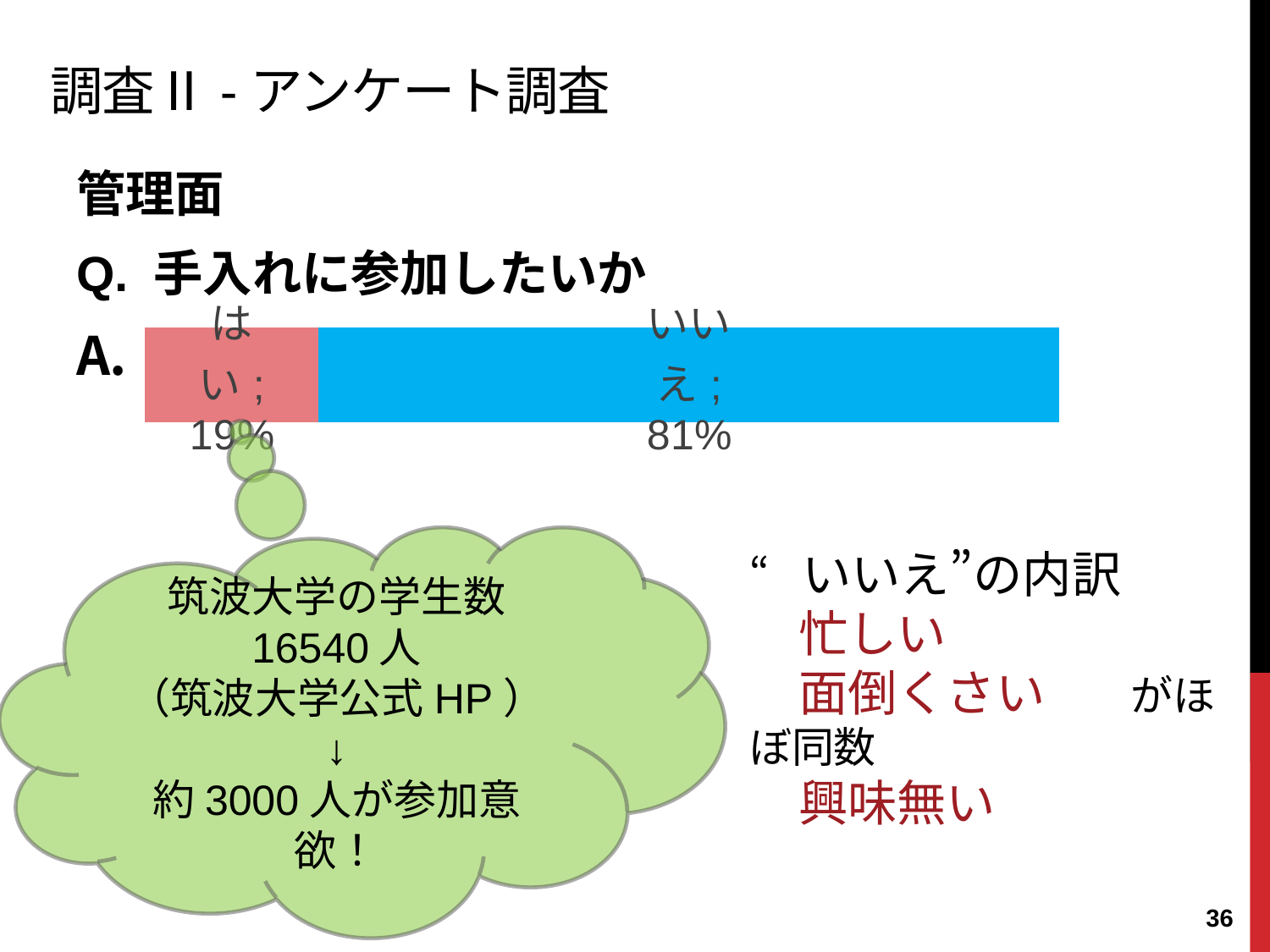
Which response has the larger share in the bar chart, はい or いいえ? いいえ What percentage of respondents answered はい (yes) in the bar chart? 19% What kind of chart is used to show the survey responses on the slide? Bar chart What percentage of respondents answered いいえ (no) in the bar chart? 81% What colour is the はい segment of the bar chart? Red Which response has the largest share in the bar chart? いいえ What colour is the いいえ segment of the bar chart? Blue How many response categories are shown in the bar chart? 2 What is the difference in percentage points between the いいえ and はい segments of the bar chart? 62 What is the total of the two segments in the stacked bar chart? 100% Which response has the smallest share in the bar chart? はい